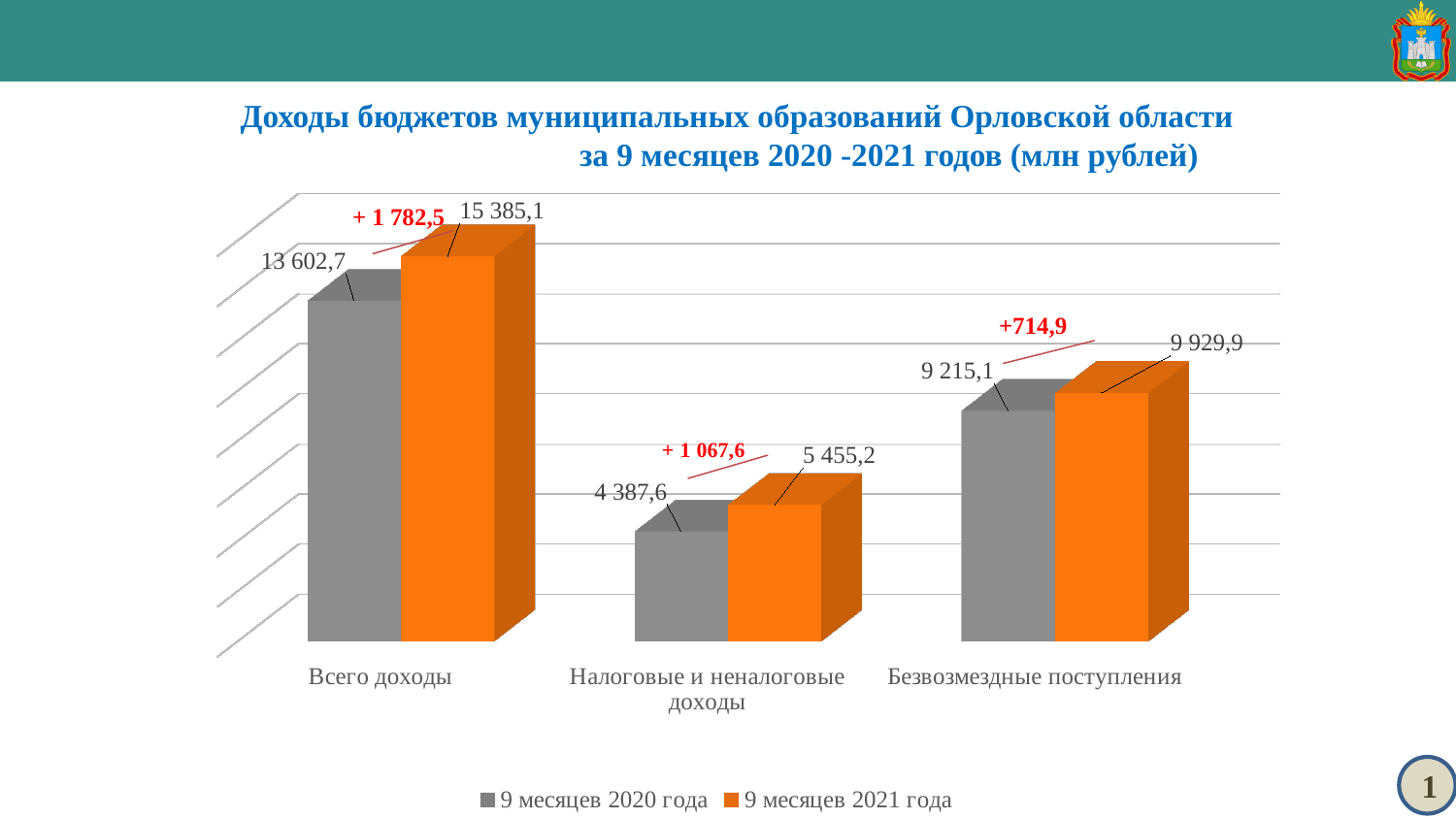
What is the value for "Всего доходы" in the "9 месяцев 2021 года" series? 15 385,1 How many series does the legend list? 2 What is the difference between the 2021 and 2020 values for "Безвозмездные поступления"? 714,9 What is the difference between the 2021 and 2020 values for "Налоговые и неналоговые доходы"? 1 067,6 What is the value for "Налоговые и неналоговые доходы" in the "9 месяцев 2021 года" series? 5 455,2 Which is larger for "Безвозмездные поступления": the "9 месяцев 2020 года" value or the "9 месяцев 2021 года" value? 9 месяцев 2021 года What is the value for "Безвозмездные поступления" in the "9 месяцев 2020 года" series? 9 215,1 How many categories are shown on the x axis? 3 Which category has the lowest value in the "9 месяцев 2020 года" series? Налоговые и неналоговые доходы What is the value for "Всего доходы" in the "9 месяцев 2020 года" series? 13 602,7 What kind of chart is shown on the slide? Bar chart Which category has the highest value in the "9 месяцев 2021 года" series? Всего доходы